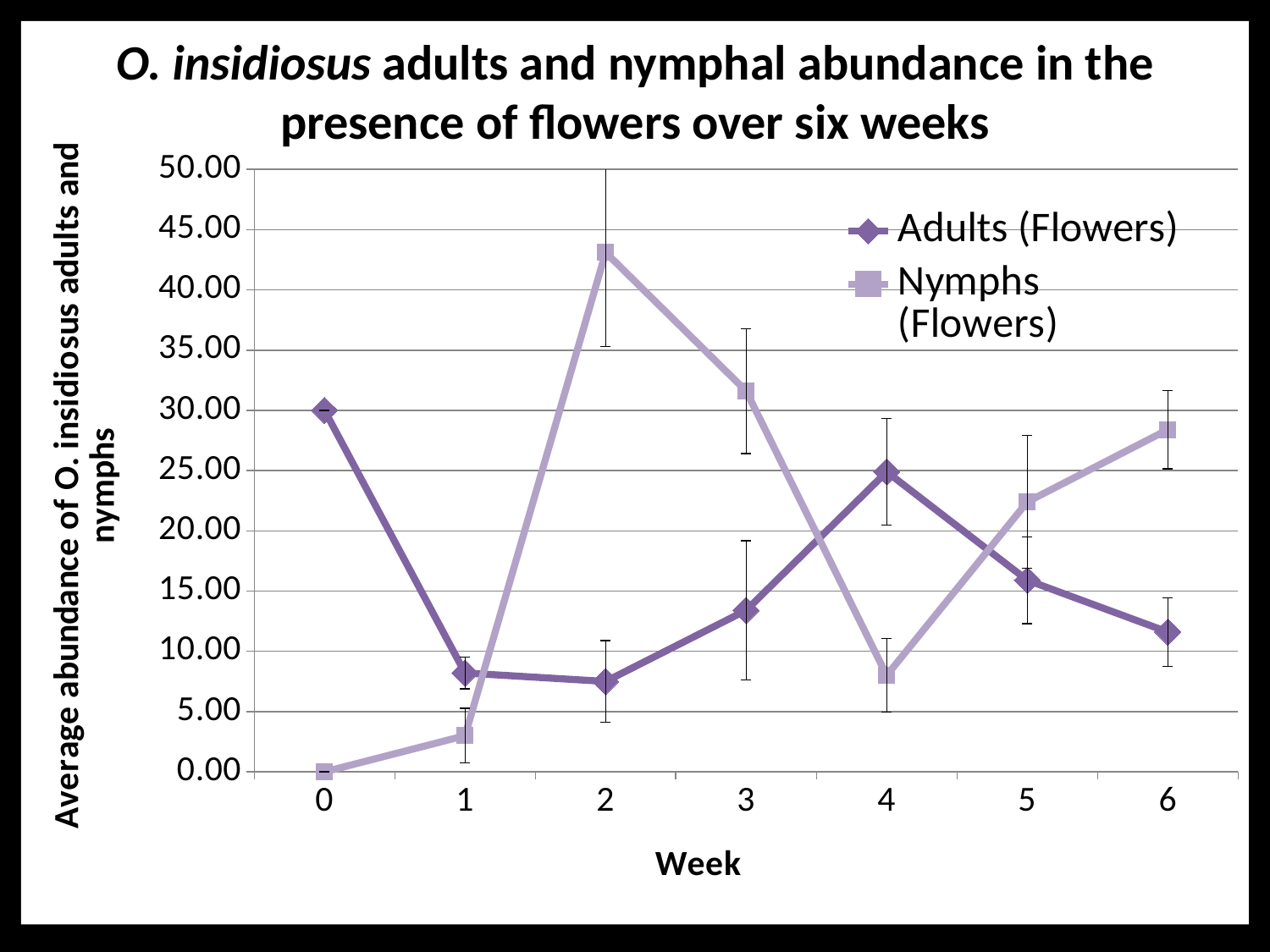
How many series does the legend list? 2 At week 4, which series has the larger value, Adults (Flowers) or Nymphs (Flowers)? Adults (Flowers) Is the value for Nymphs (Flowers) at week 2 greater or less than 40.00? greater Does the Adults (Flowers) series rise or fall from week 4 to week 6? fall What is the value for Nymphs (Flowers) at week 0? 0.00 At which week is the Adults (Flowers) series highest? 0 How many weeks are plotted along the x axis? 7 At which week is the Nymphs (Flowers) series highest? 2 At which week is the Nymphs (Flowers) series lowest? 0 Is the value for Adults (Flowers) at week 1 greater or less than 10.00? less What kind of chart is shown on the slide? line chart Is the value for Nymphs (Flowers) at week 6 greater or less than 25.00? greater